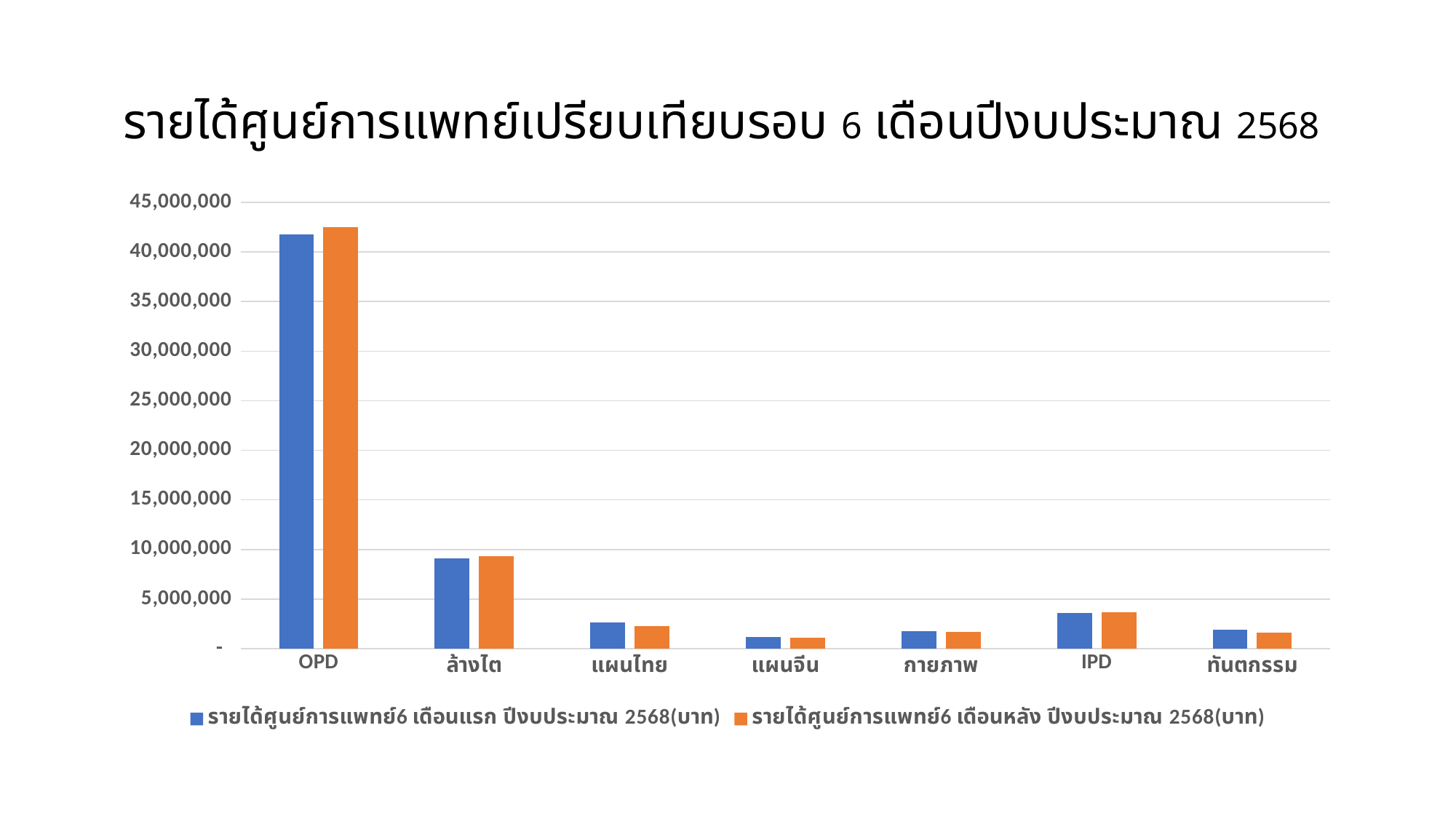
What kind of chart is shown on the slide? bar chart Is the value for ล้างไต in the blue series greater or less than 5,000,000? greater Is the value for OPD in the blue series greater or less than 40,000,000? greater Which is larger for the blue series: the value for OPD or the value for ล้างไต? OPD How many series does the legend list? 2 Is the value for ล้างไต in the orange series greater or less than 10,000,000? less What colour are the bars for the series รายได้ศูนย์การแพทย์6 เดือนหลัง ปีงบประมาณ 2568(บาท)? orange Which category has the highest value for the blue series (รายได้ศูนย์การแพทย์6 เดือนแรก ปีงบประมาณ 2568)? OPD Which is larger for the orange series: the value for IPD or the value for แผนจีน? IPD Which category has the lowest value for the orange series (รายได้ศูนย์การแพทย์6 เดือนหลัง ปีงบประมาณ 2568)? แผนจีน How many categories are shown along the x axis of the chart? 7